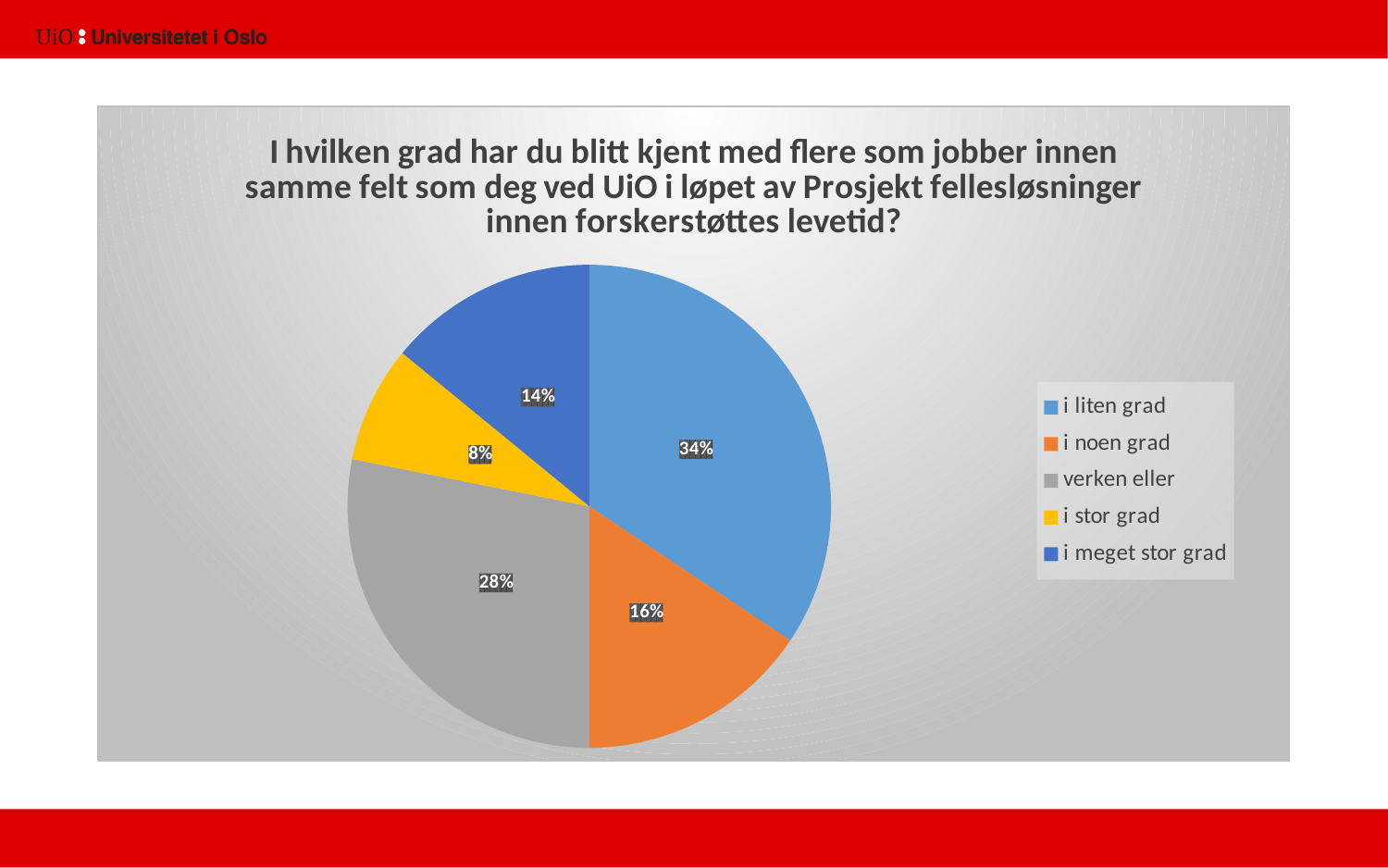
How many categories does the legend list? 5 Which category has the smallest slice of the pie? i stor grad What kind of chart is shown on the slide? pie chart What colour is the slice for 'i stor grad'? yellow What share of the pie is 'i noen grad'? 16% What share of the pie is 'i stor grad'? 8% Which is larger, the slice for 'i noen grad' or the slice for 'i meget stor grad'? i noen grad What is the difference in percentage points between 'i liten grad' and 'verken eller'? 6 What share of the pie is 'i liten grad'? 34% Which category has the largest slice of the pie? i liten grad